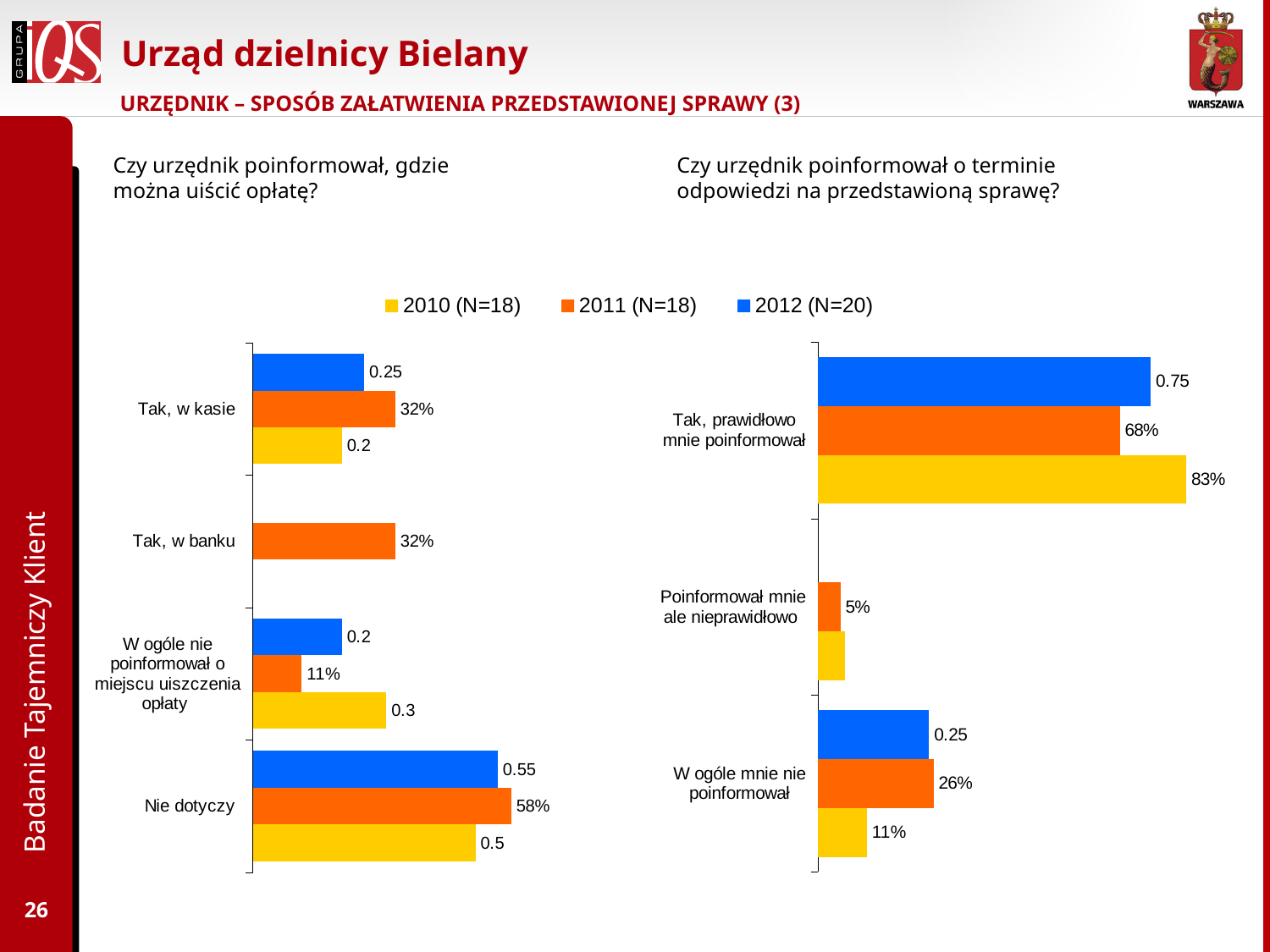
In the right chart (Czy urzędnik poinformował o terminie odpowiedzi na przedstawioną sprawę?), which category has the highest value for 2012 (N=20)? Tak, prawidłowo mnie poinformował How many categories are shown in the left chart (Czy urzędnik poinformował, gdzie można uiścić opłatę?)? 4 How many series does the legend list? 3 In the left chart (Czy urzędnik poinformował, gdzie można uiścić opłatę?), what is the value for 2010 (N=18) for 'W ogóle nie poinformował o miejscu uiszczenia opłaty'? 0.3 In the right chart (Czy urzędnik poinformował o terminie odpowiedzi na przedstawioną sprawę?), what is the value for 2010 (N=18) for 'Tak, prawidłowo mnie poinformował'? 83% In the right chart (Czy urzędnik poinformował o terminie odpowiedzi na przedstawioną sprawę?), what is the value for 2011 (N=18) for 'W ogóle mnie nie poinformował'? 26% In the left chart (Czy urzędnik poinformował, gdzie można uiścić opłatę?), what is the value for 2011 (N=18) for 'Tak, w kasie'? 32% In the right chart (Czy urzędnik poinformował o terminie odpowiedzi na przedstawioną sprawę?), for 'W ogóle mnie nie poinformował', which is larger: the 2011 (N=18) value or the 2010 (N=18) value? 2011 (N=18) In the left chart (Czy urzędnik poinformował, gdzie można uiścić opłatę?), what is the value for 2012 (N=20) for 'Nie dotyczy'? 0.55 In the left chart (Czy urzędnik poinformował, gdzie można uiścić opłatę?), which category has the lowest value for 2011 (N=18)? W ogóle nie poinformował o miejscu uiszczenia opłaty What kind of chart is the right chart (Czy urzędnik poinformował o terminie odpowiedzi na przedstawioną sprawę?)? Bar chart In the right chart (Czy urzędnik poinformował o terminie odpowiedzi na przedstawioną sprawę?), what is the difference between the 2010 (N=18) and 2011 (N=18) values for 'Tak, prawidłowo mnie poinformował'? 15 percentage points